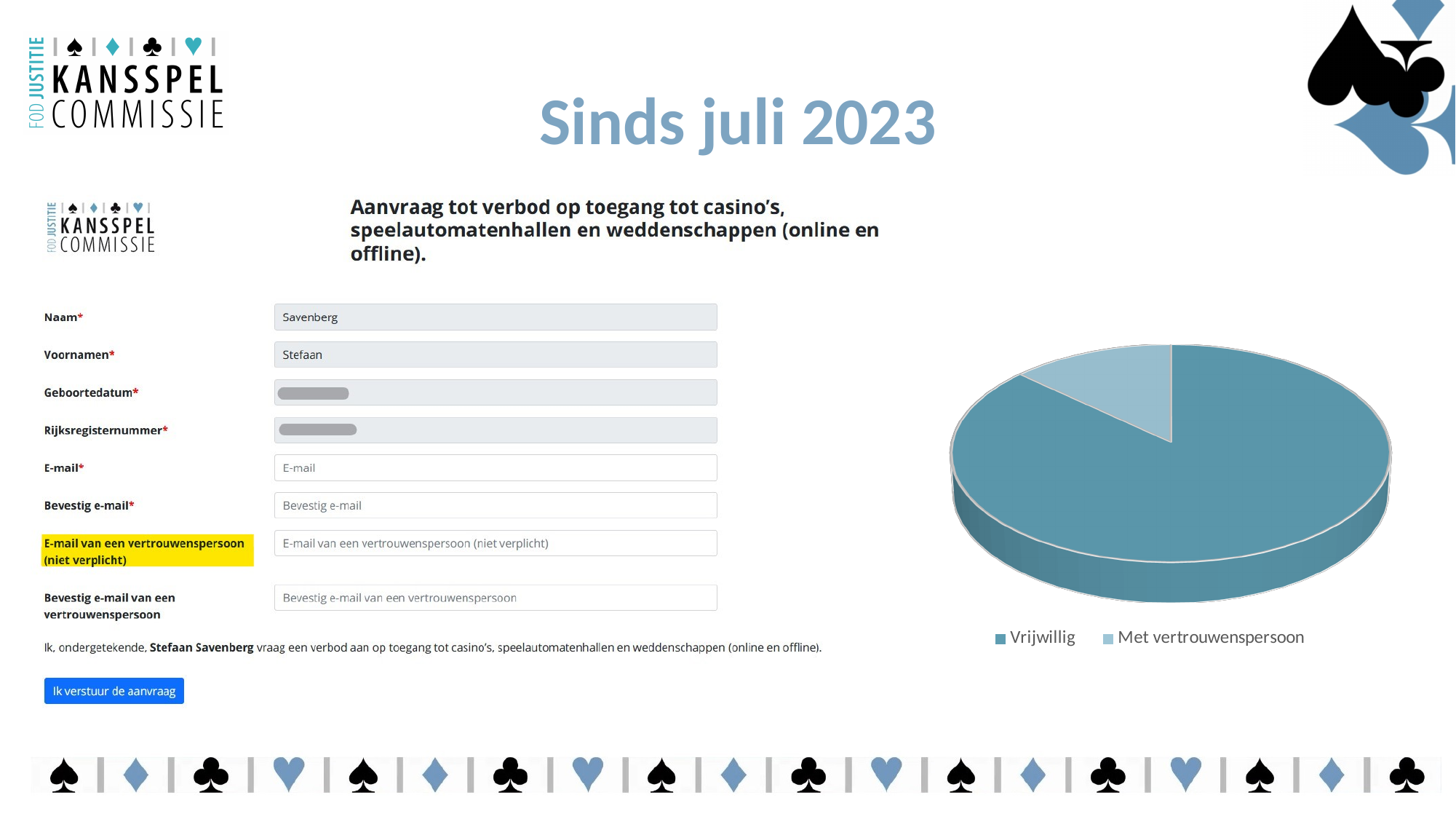
How many slices does the pie chart have? 2 Which slice of the pie chart is the largest? Vrijwillig What kind of chart is shown on the right side of the slide? pie chart How many entries does the legend of the pie chart list? 2 Which legend entry of the pie chart is shown in the lighter blue colour? Met vertrouwenspersoon Does the Vrijwillig slice make up more or less than half of the pie chart? more What are the two legend entries of the pie chart? Vrijwillig, Met vertrouwenspersoon Which slice of the pie chart is the smallest? Met vertrouwenspersoon In the pie chart, which is larger: Vrijwillig or Met vertrouwenspersoon? Vrijwillig